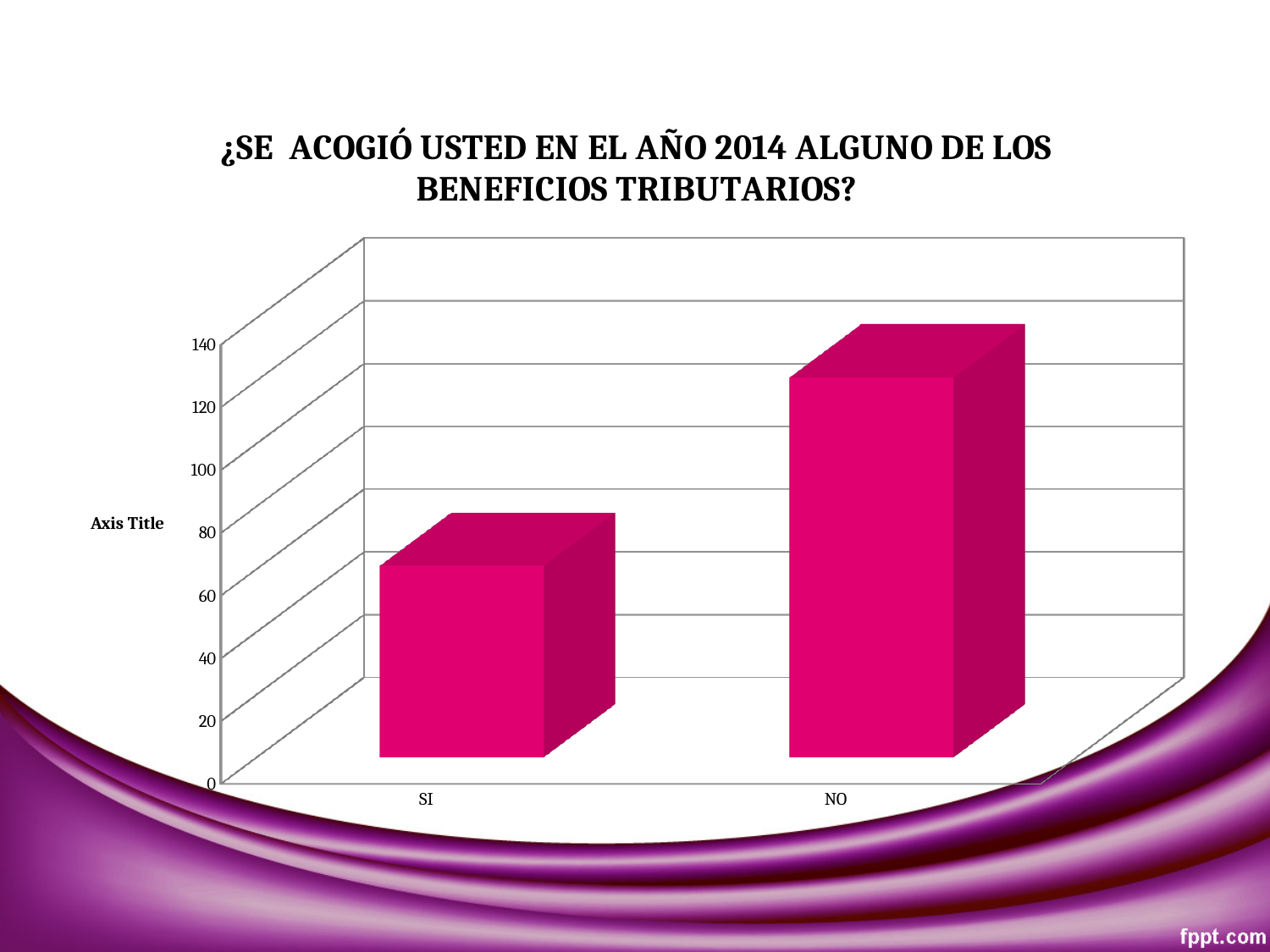
Is the value for NO greater or less than 140? less What is the title of the chart? ¿SE ACOGIÓ USTED EN EL AÑO 2014 ALGUNO DE LOS BENEFICIOS TRIBUTARIOS? How many categories are shown on the x axis of the chart? 2 Is the value for SI greater or less than 100? less Which category has the lowest bar in the chart? SI What kind of chart is shown on the slide? bar chart Is the value for NO greater or less than 100? greater Which bar is taller, SI or NO? NO What is the label shown on the vertical axis of the chart? Axis Title Which category has the highest bar in the chart? NO